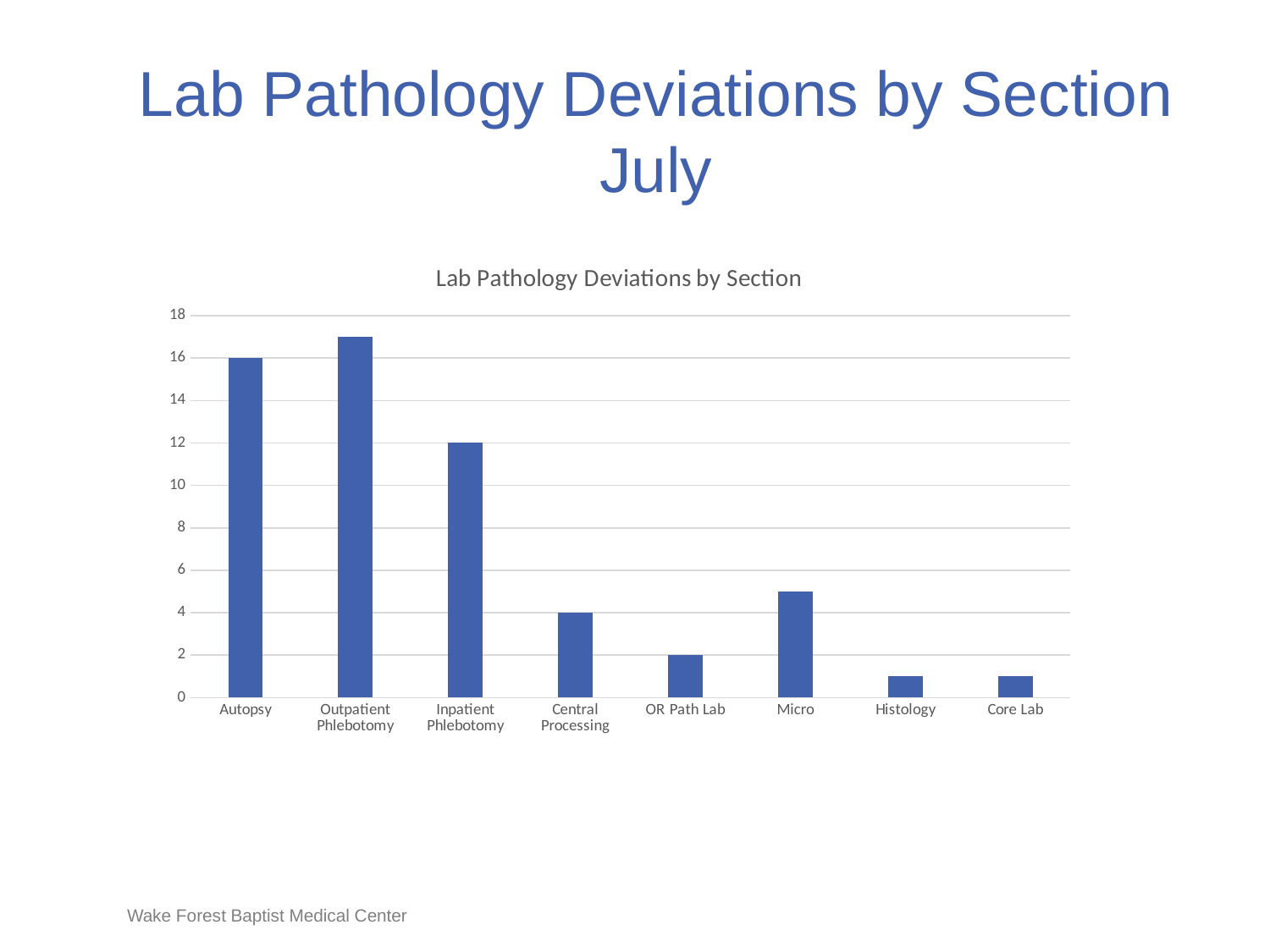
What is the title of the chart? Lab Pathology Deviations by Section What is the value for Central Processing? 4 Which section has the highest number of deviations? Outpatient Phlebotomy What is the difference between the values for Autopsy and Inpatient Phlebotomy? 4 Which is larger, the value for Inpatient Phlebotomy or the value for Micro? Inpatient Phlebotomy How many sections are shown on the x axis of the chart? 8 What is the value for OR Path Lab? 2 What type of chart is shown on the slide? bar chart Is the value for Micro greater or less than 6? less Is the value for Outpatient Phlebotomy greater or less than 16? greater What is the value for Inpatient Phlebotomy? 12 What is the value for Autopsy? 16